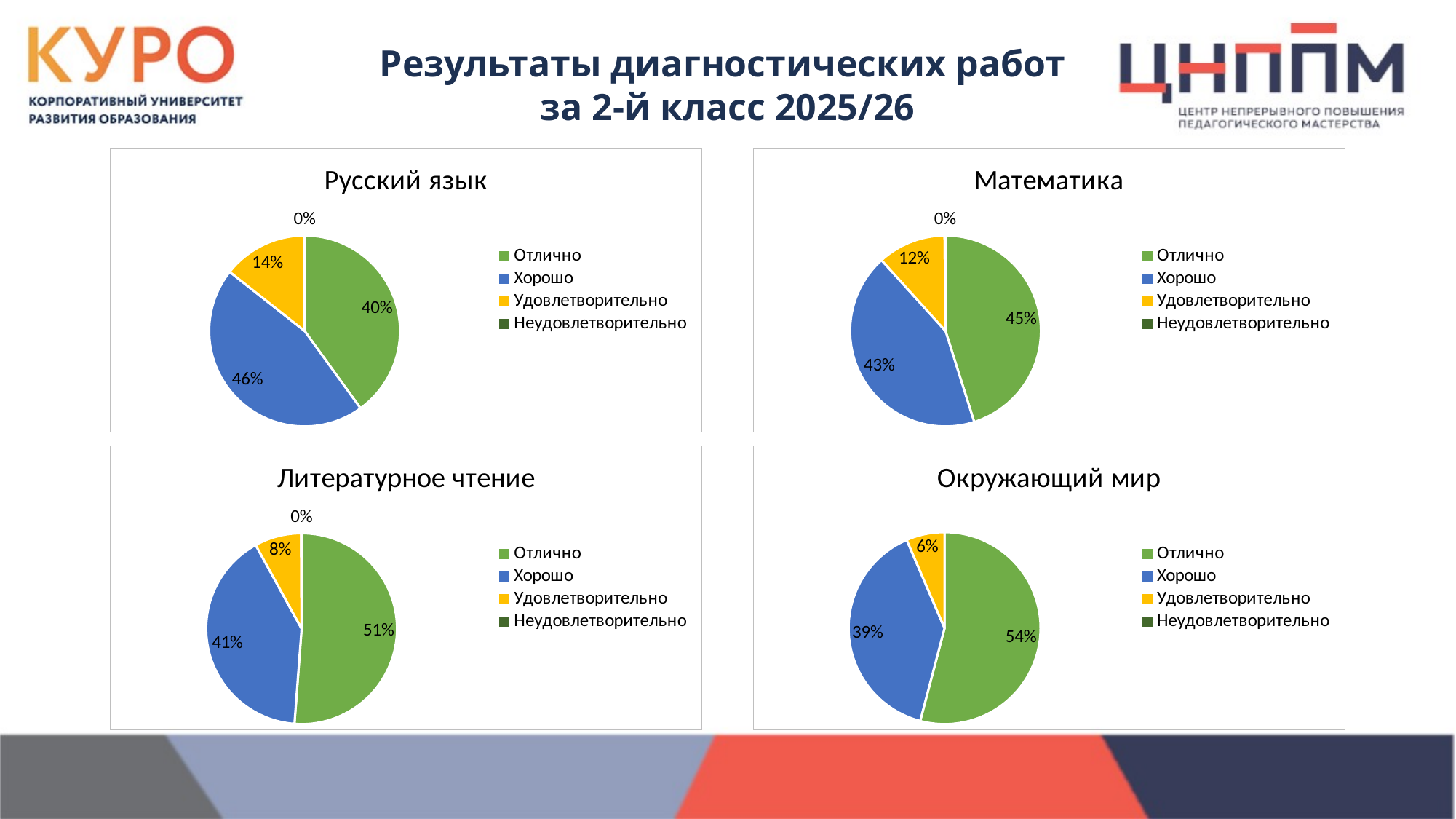
What type of chart is used for "Математика"? Pie chart In the "Русский язык" chart, which category has the largest slice? Хорошо In the "Окружающий мир" chart, which category has the largest slice? Отлично In the "Литературное чтение" chart, what is the difference between the Отлично and Хорошо shares? 10% In the "Математика" chart, which category has the smallest share? Неудовлетворительно How many categories does the legend of the "Окружающий мир" chart list? 4 In the "Русский язык" chart, what share is labelled for Хорошо? 46% In the "Литературное чтение" chart, what colour represents Удовлетворительно? Yellow In the "Математика" chart, what share is labelled for Отлично? 45% In the "Литературное чтение" chart, what share is labelled for Удовлетворительно? 8% In the "Окружающий мир" chart, what share is labelled for Хорошо? 39% In the "Русский язык" chart, which is larger: Удовлетворительно or Отлично? Отлично